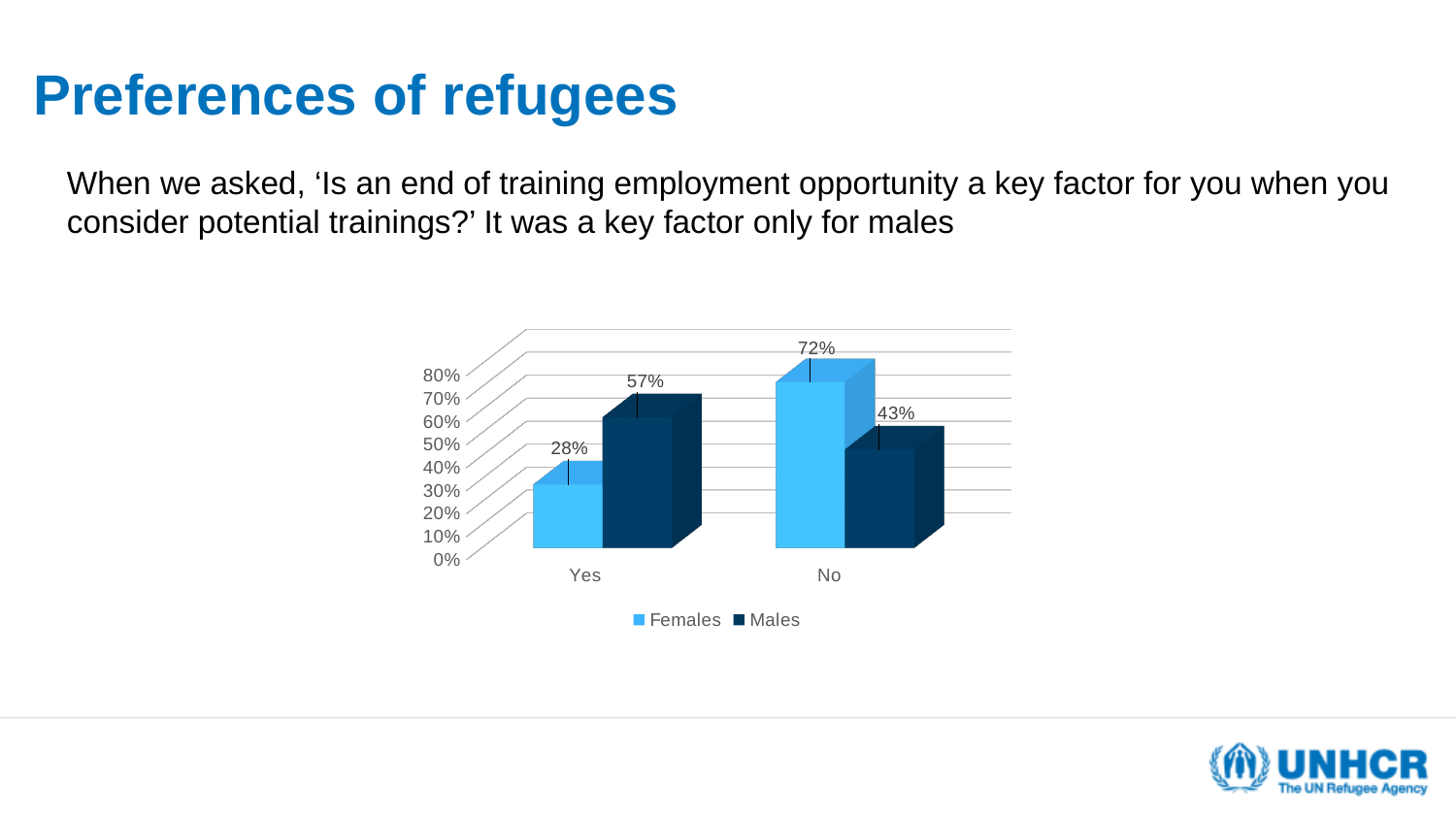
How many categories are shown on the x axis? 2 Which bar has the highest value in the chart? Females, No What percentage of females answered Yes? 28% What is the difference between the Females and Males values for No? 29% For the Yes category, which series has the larger value, Females or Males? Males What percentage of females answered No? 72% What kind of chart is shown on the slide? Bar chart What percentage of males answered No? 43% What is the difference between the Females and Males values for Yes? 29% Which bar has the lowest value in the chart? Females, Yes What percentage of males answered Yes? 57% How many series does the legend list? 2